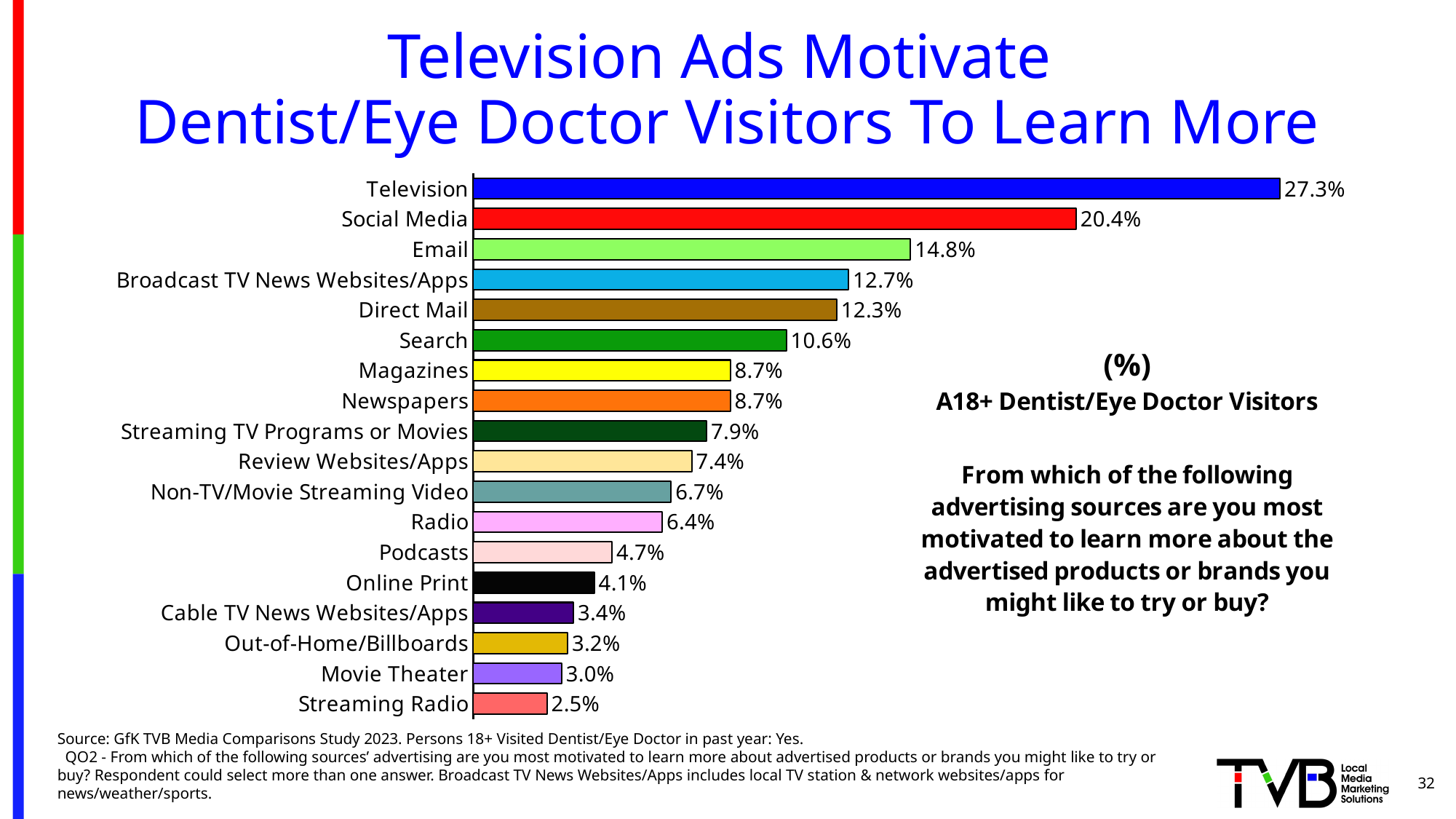
What is the value shown for Podcasts? 4.7% Which has a larger value, Radio or Online Print? Radio How many advertising sources are listed on the chart? 18 Which has a larger value, Broadcast TV News Websites/Apps or Cable TV News Websites/Apps? Broadcast TV News Websites/Apps What kind of chart is shown on the slide? Bar chart Which advertising source has the highest value on the chart? Television Which two advertising sources share the same value of 8.7%? Magazines and Newspapers What is the difference between the values for Television and Social Media? 6.9% What is the difference between the values for Email and Search? 4.2% Which advertising source has the lowest value on the chart? Streaming Radio What is the value shown for Direct Mail? 12.3% What percentage of A18+ Dentist/Eye Doctor Visitors are most motivated by Television ads to learn more? 27.3%